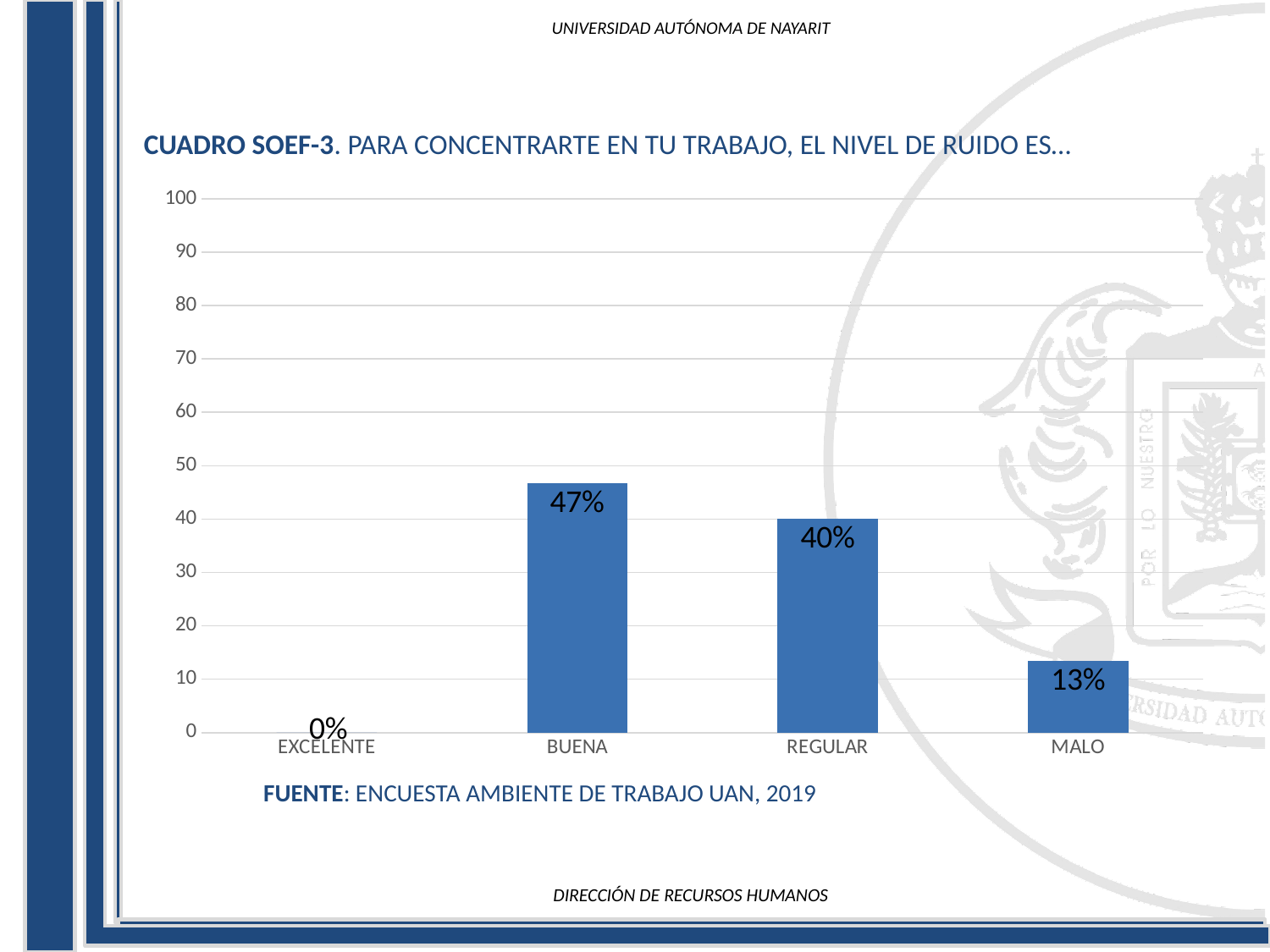
What is the value for REGULAR? 40% Which is larger, the value for REGULAR or the value for MALO? REGULAR What is the value for MALO? 13% What is the difference between the values for BUENA and REGULAR? 7% What is the difference between the values for REGULAR and MALO? 27% Which category has the lowest value? EXCELENTE What kind of chart is shown on the slide? bar chart Which category has the highest value? BUENA Is the value for BUENA greater or less than 50? less How many categories are shown on the x axis? 4 What is the value for EXCELENTE? 0% What is the value for BUENA? 47%